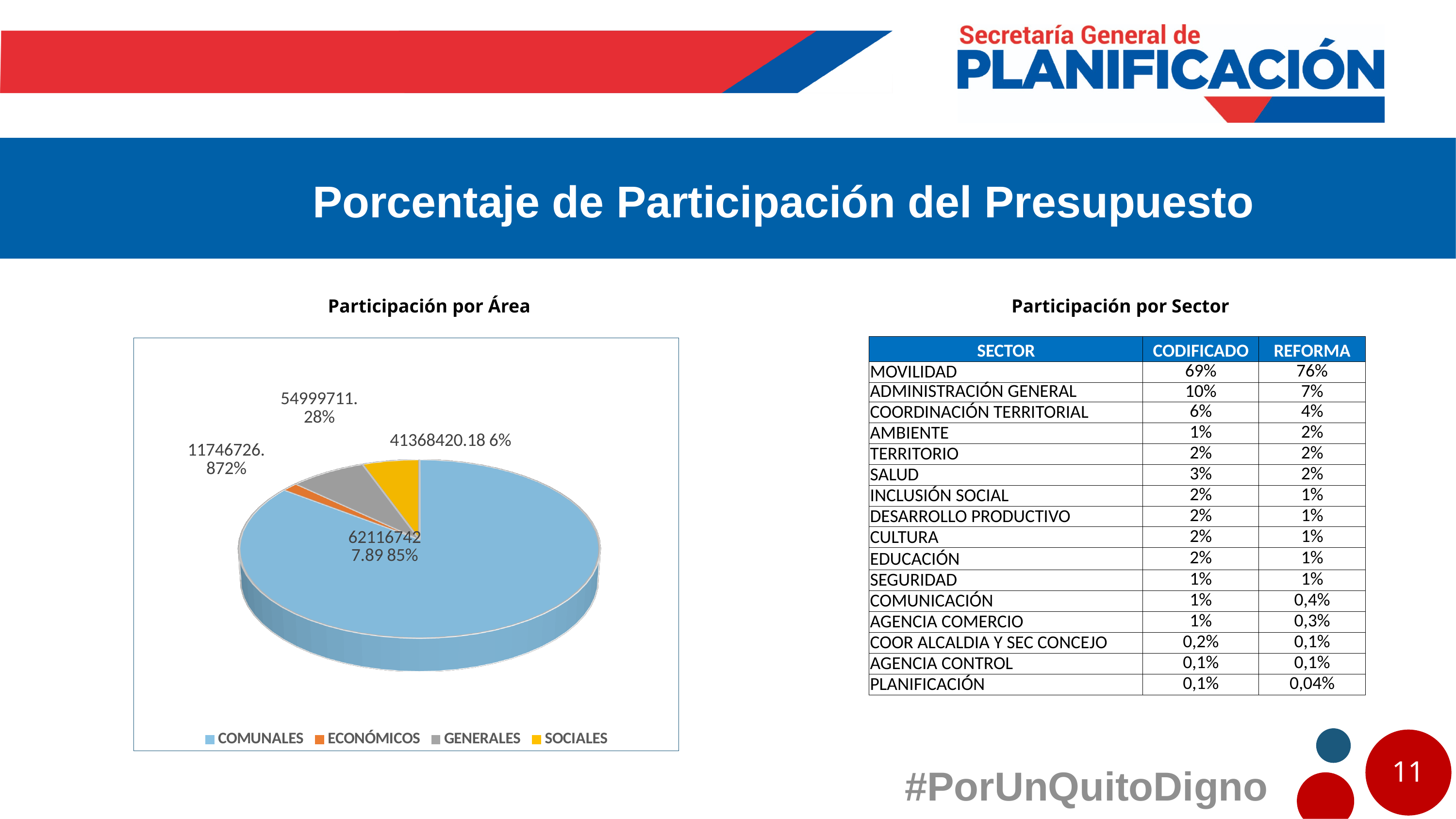
In the "Participación por Área" pie chart, what percentage share is labelled for the COMUNALES slice? 85% In the "Participación por Área" pie chart, which category has the smallest slice? ECONÓMICOS In the "Participación por Área" pie chart, which category has the largest slice? COMUNALES What are the legend entries of the "Participación por Área" pie chart? COMUNALES, ECONÓMICOS, GENERALES, SOCIALES In the "Participación por Área" pie chart, what colour is the COMUNALES slice? light blue What kind of chart is the "Participación por Área" chart? pie chart How many categories does the "Participación por Área" pie chart show? 4 In the "Participación por Área" pie chart, which slice is larger, ECONÓMICOS or GENERALES? GENERALES In the "Participación por Área" pie chart, which slice is larger, COMUNALES or SOCIALES? COMUNALES